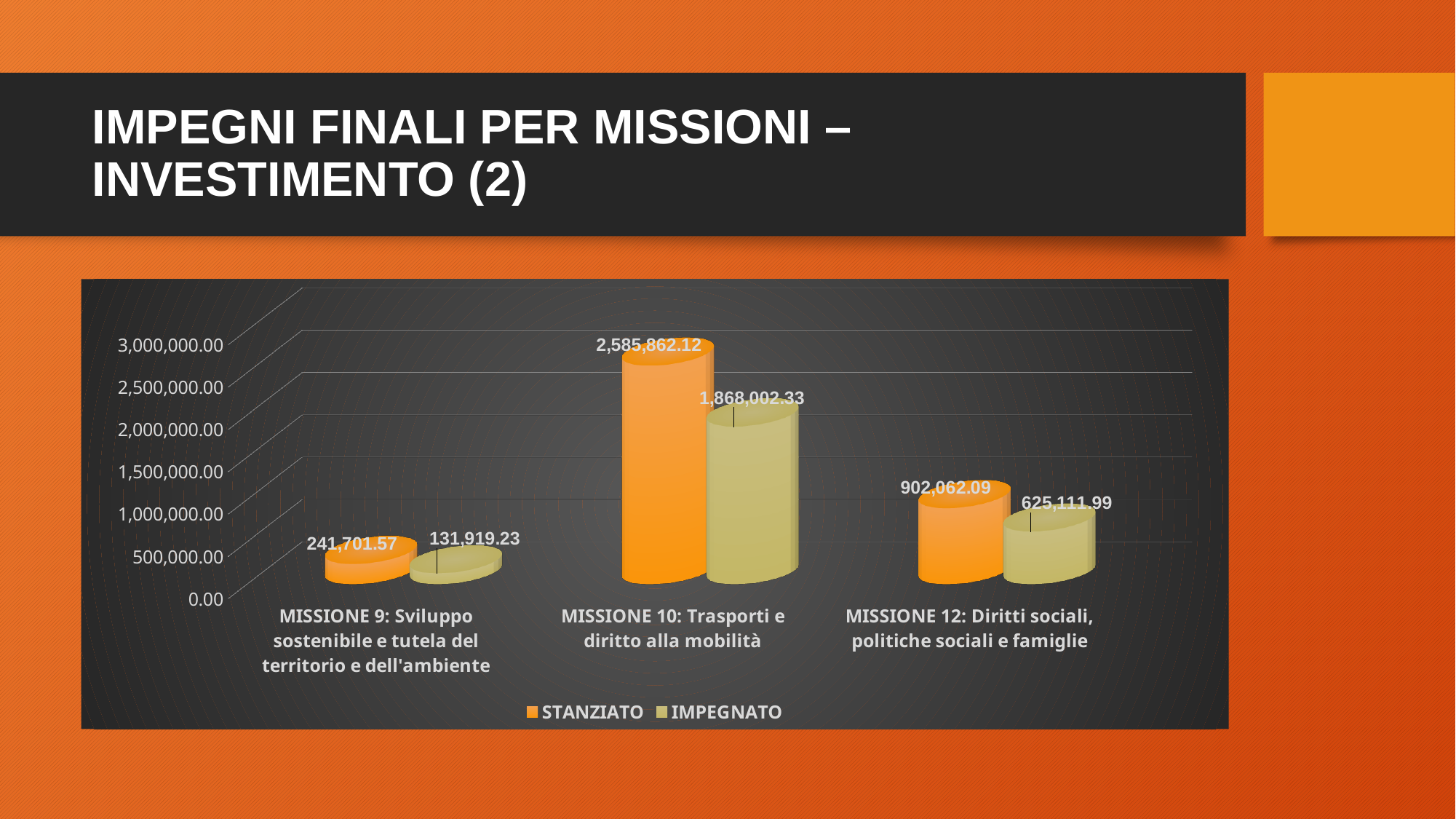
What is the STANZIATO value for MISSIONE 10: Trasporti e diritto alla mobilità? 2,585,862.12 What is the IMPEGNATO value for MISSIONE 12: Diritti sociali, politiche sociali e famiglie? 625,111.99 How many missions (categories) are shown on the chart? 3 Which mission has the lowest IMPEGNATO value? MISSIONE 9: Sviluppo sostenibile e tutela del territorio e dell'ambiente What kind of chart is shown on the slide? Bar chart What is the difference between the STANZIATO and IMPEGNATO values for MISSIONE 12? 276,950.10 What is the STANZIATO value for MISSIONE 12: Diritti sociali, politiche sociali e famiglie? 902,062.09 Which mission has the highest STANZIATO value? MISSIONE 10: Trasporti e diritto alla mobilità What is the IMPEGNATO value for MISSIONE 9: Sviluppo sostenibile e tutela del territorio e dell'ambiente? 131,919.23 How many series does the legend list? 2 What is the difference between the STANZIATO and IMPEGNATO values for MISSIONE 10? 717,859.79 Which is larger for MISSIONE 9: the STANZIATO value or the IMPEGNATO value? STANZIATO